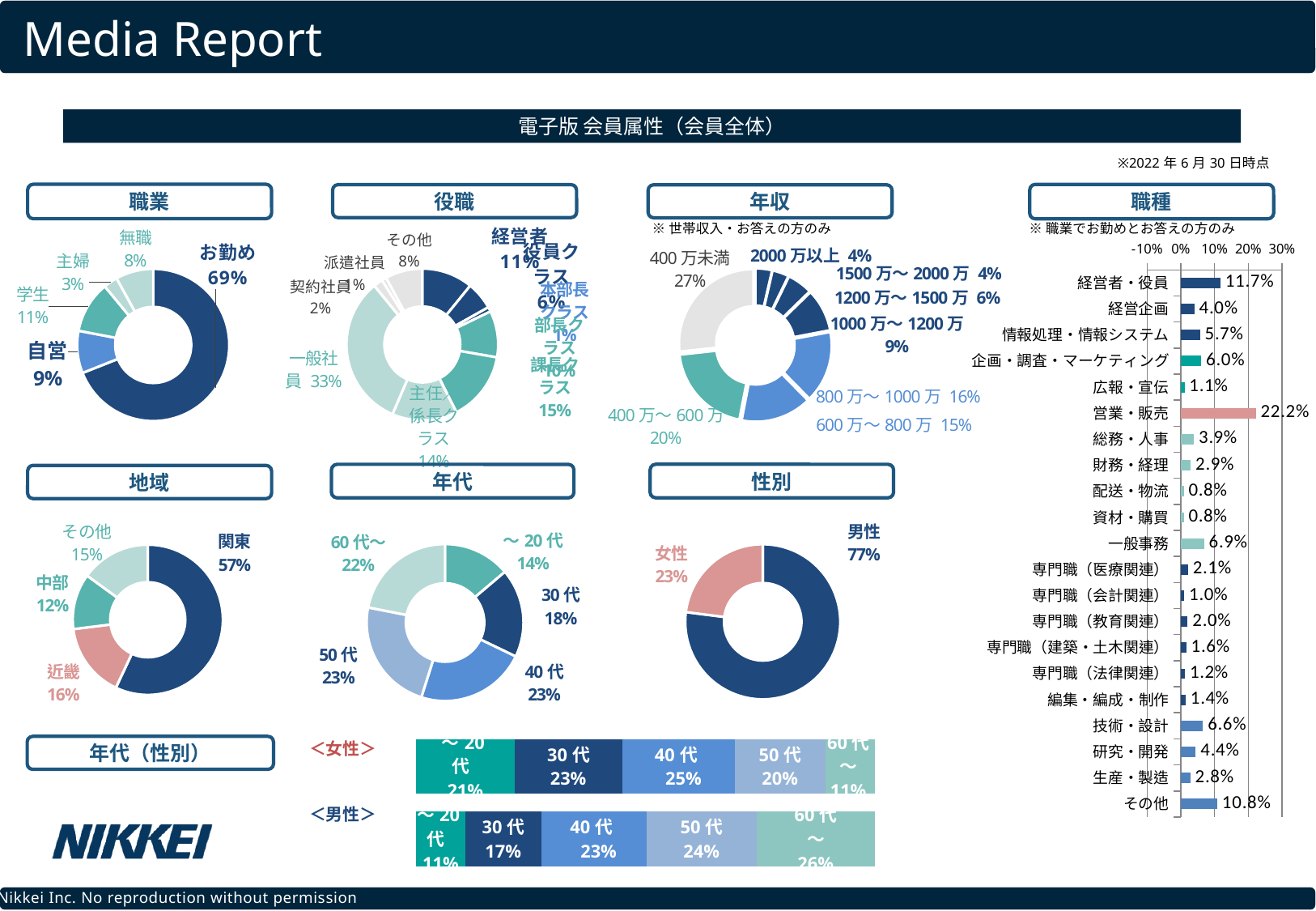
In the 性別 chart, what is the value for 男性? 77% In the 年代 chart, which is larger, 30代 or 60代〜? 60代〜 In the 職種 bar chart, which category has the highest value? 営業・販売 In the 職業 chart, what share is お勤め? 69% In the 地域 chart, which region has the largest share? 関東 What kind of chart is the 職種 chart? bar chart In the 年代（性別） chart, what is the value for 60代〜 in the 男性 bar? 26% In the 職種 bar chart, what is the value for 経営者・役員? 11.7% In the 年収 chart, what is the value for 400万未満? 27% In the 年代（性別） chart, which is larger, 40代 for 女性 or 40代 for 男性? 女性 In the 職種 bar chart, what is the difference between 営業・販売 and その他? 11.4% In the 地域 chart, what is the difference between 関東 and 近畿? 41%